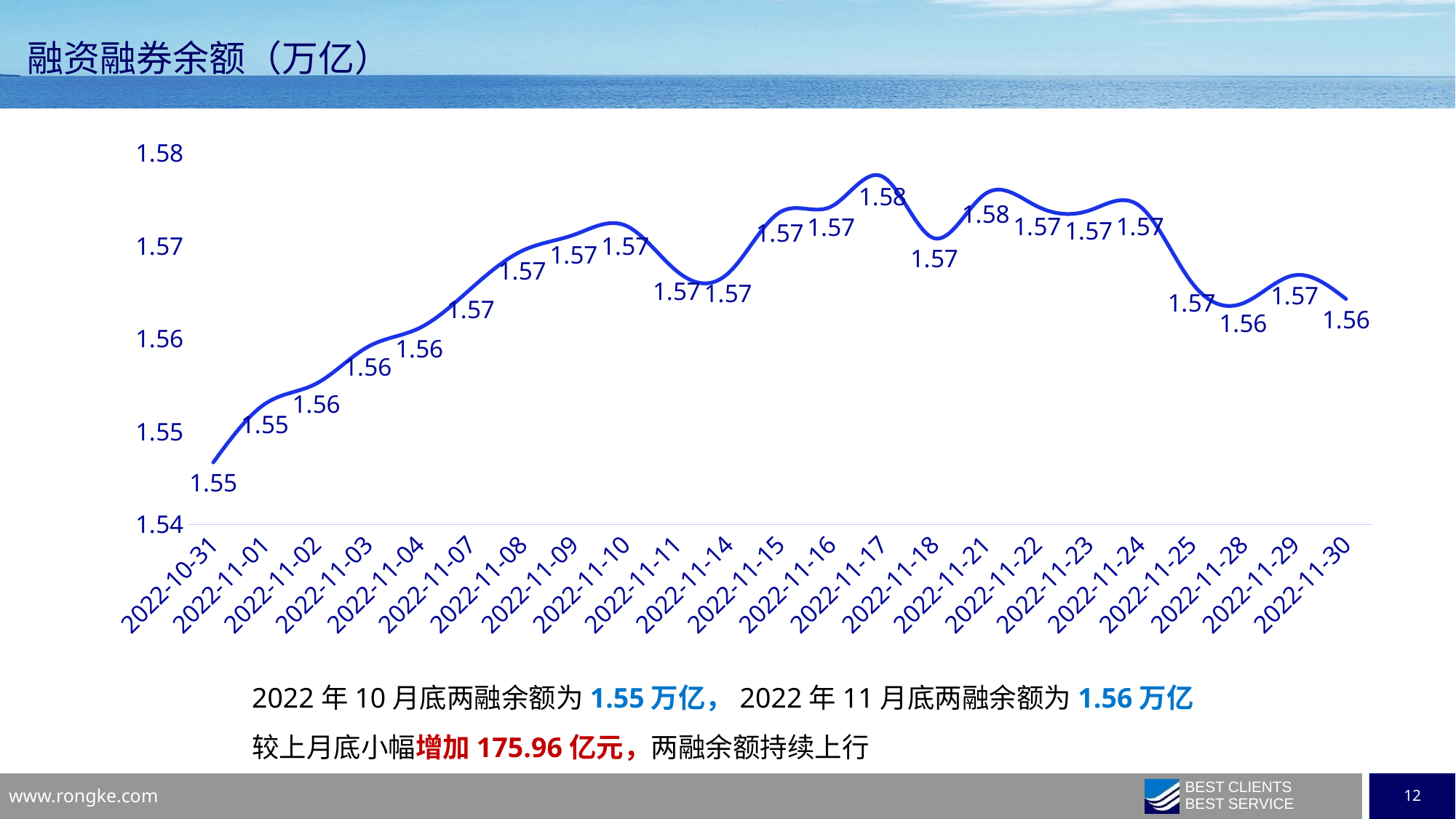
What is the value for 2022-11-30? 1.56 What is the value for 2022-11-17? 1.58 What is the value for 2022-10-31? 1.55 What is the value for 2022-11-04? 1.56 Is the value for 2022-10-31 greater or less than 1.56? less How many dates are plotted on the x axis? 23 What is the title of the chart? 融资融券余额（万亿） Which is larger, the value for 2022-11-17 or the value for 2022-11-01? 2022-11-17 Which date has the lowest value on the chart? 2022-10-31 Is the value for 2022-11-17 greater or less than 1.57? greater What is the difference between the value for 2022-11-17 and the value for 2022-10-31? 0.03 What kind of chart is shown on the slide? line chart